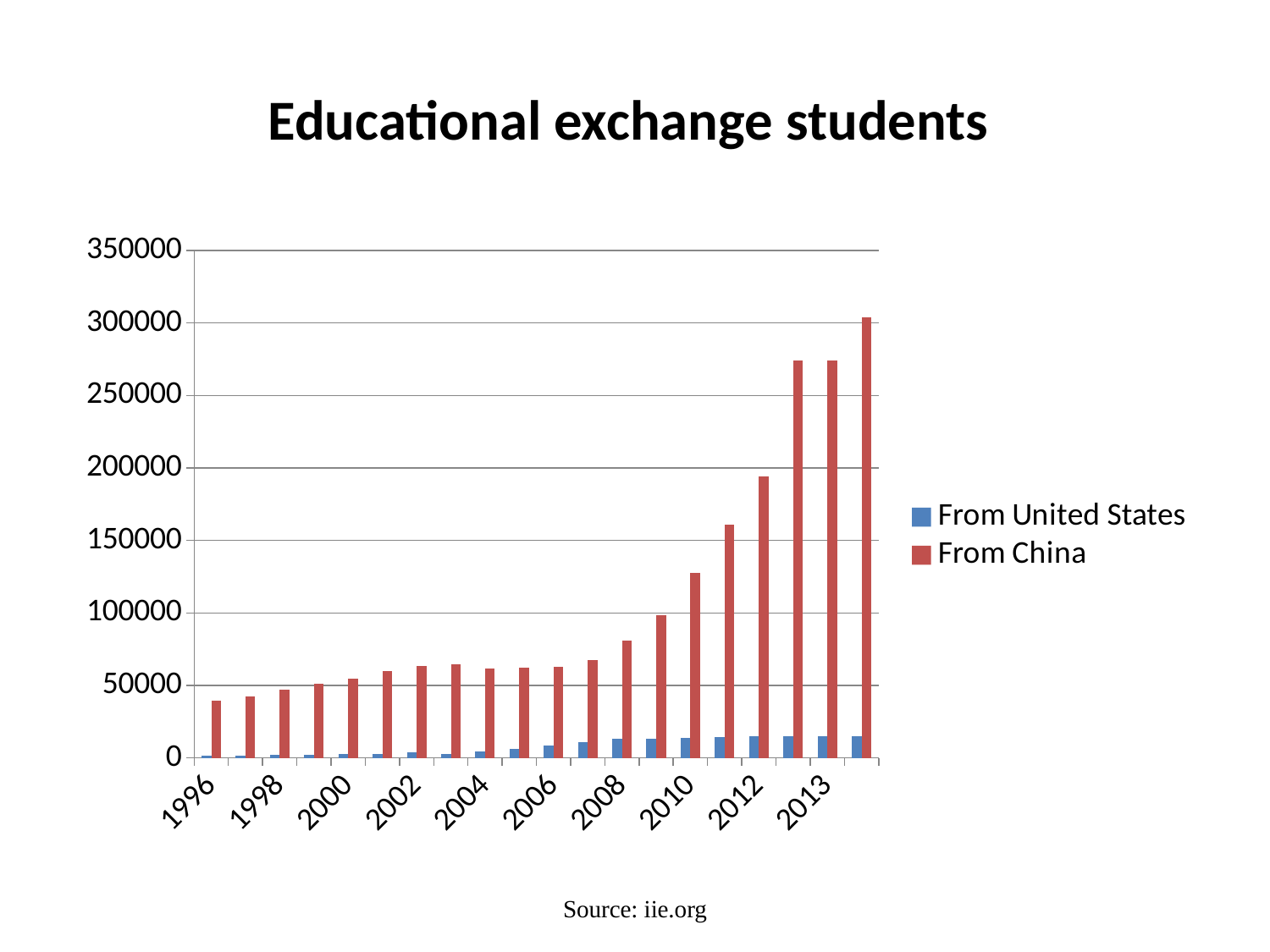
Is the value for From China in 2008 greater or less than 100000? less What is the title of the chart? Educational exchange students Is the value for From United States in 2012 greater or less than 50000? less In 2010, which series has the larger value, From United States or From China? From China Is the value for From China in 2012 greater or less than 150000? greater What kind of chart is shown on the slide? bar chart Do the values for From China generally rise or fall from 1996 to the end of the x axis? rise How many series does the legend list? 2 Which series is shown in red? From China Which series has the larger value in 2000, From China or From United States? From China